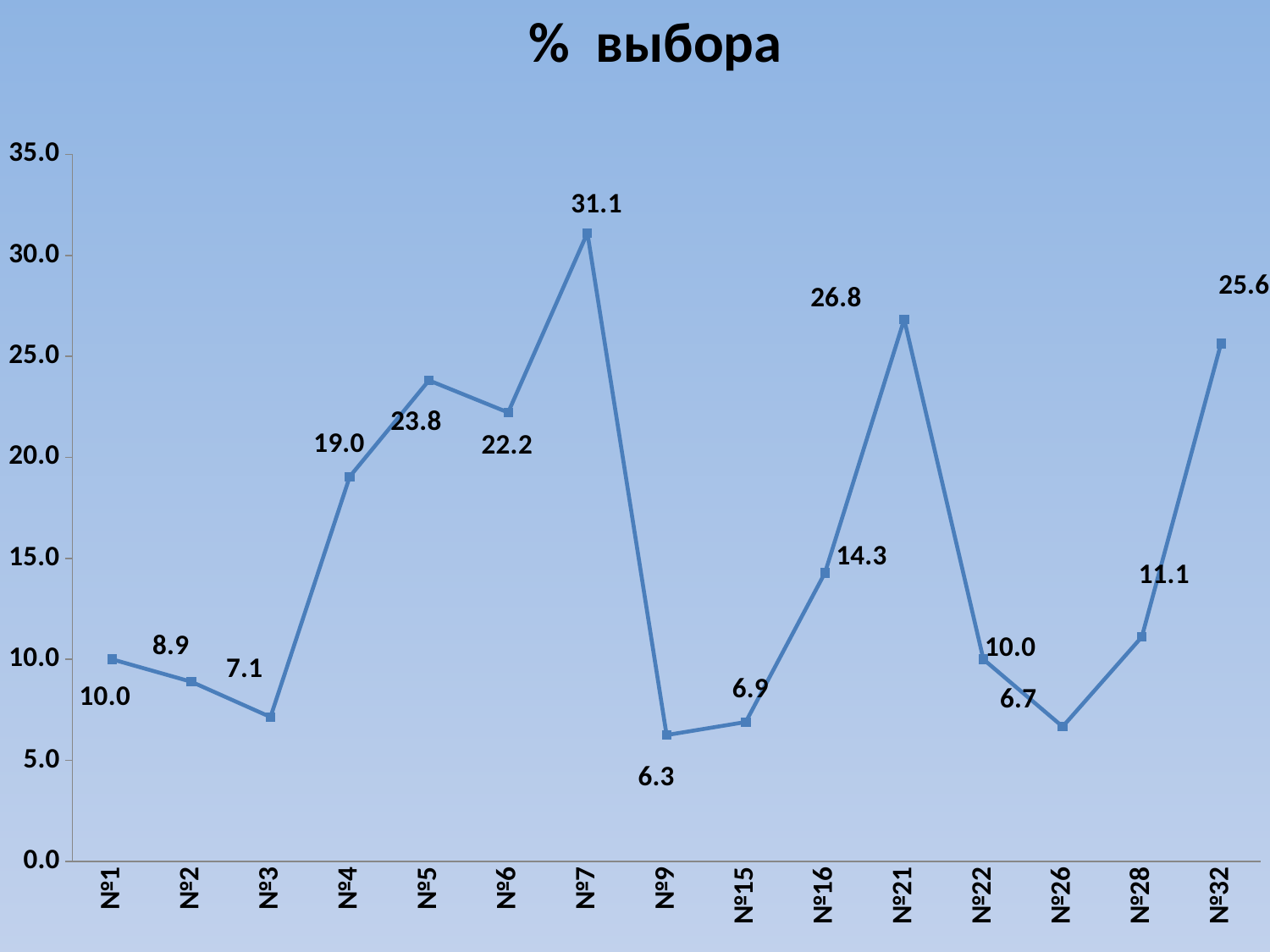
What is the value for №3? 7.1 What is the value for №32? 25.6 What is the value for №21? 26.8 What is the difference between the values for №5 and №6? 1.6 What kind of chart is shown on the slide? Line chart What is the difference between the values for №7 and №21? 4.3 What is the value for №7? 31.1 What is the title of the chart? % выбора How many categories are plotted on the x axis? 15 Which category has the lowest value? №9 Which category has the highest value? №7 Which is larger, the value for №16 or the value for №28? №16